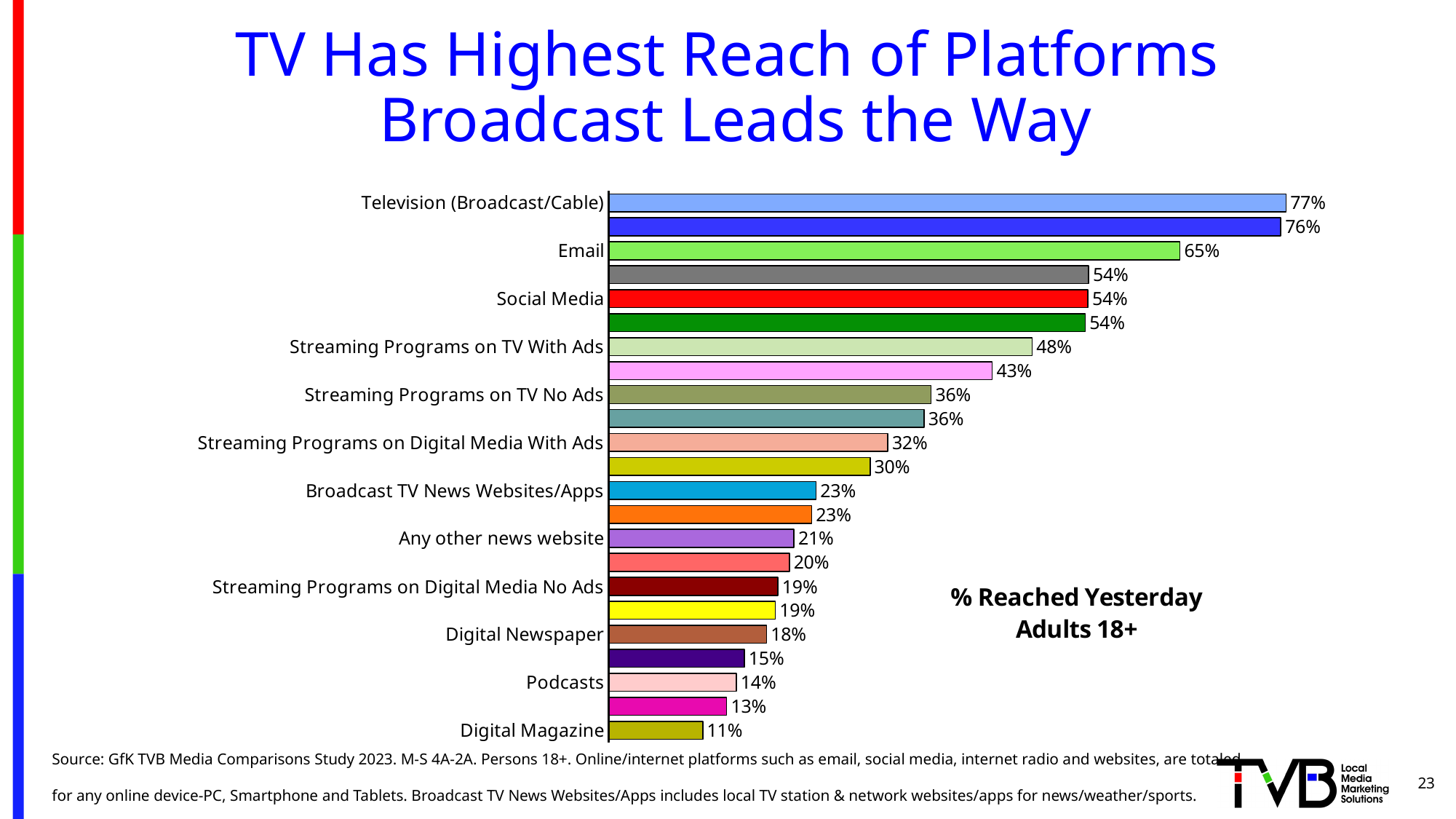
What kind of chart is shown on the slide? Bar chart What is the value for Television (Broadcast/Cable)? 77% Which is larger, the value for Streaming Programs on TV No Ads or the value for Digital Newspaper? Streaming Programs on TV No Ads What measure does the chart report, according to the text next to the bars? % Reached Yesterday, Adults 18+ Which labeled category has the highest value? Television (Broadcast/Cable) What is the value for Streaming Programs on TV With Ads? 48% What is the difference between the values for Email and Social Media? 11 percentage points Which labeled category has the lowest value? Digital Magazine What is the value for Broadcast TV News Websites/Apps? 23% How many bars are plotted in the chart? 23 What is the value for Email? 65% What is the value for Podcasts? 14%